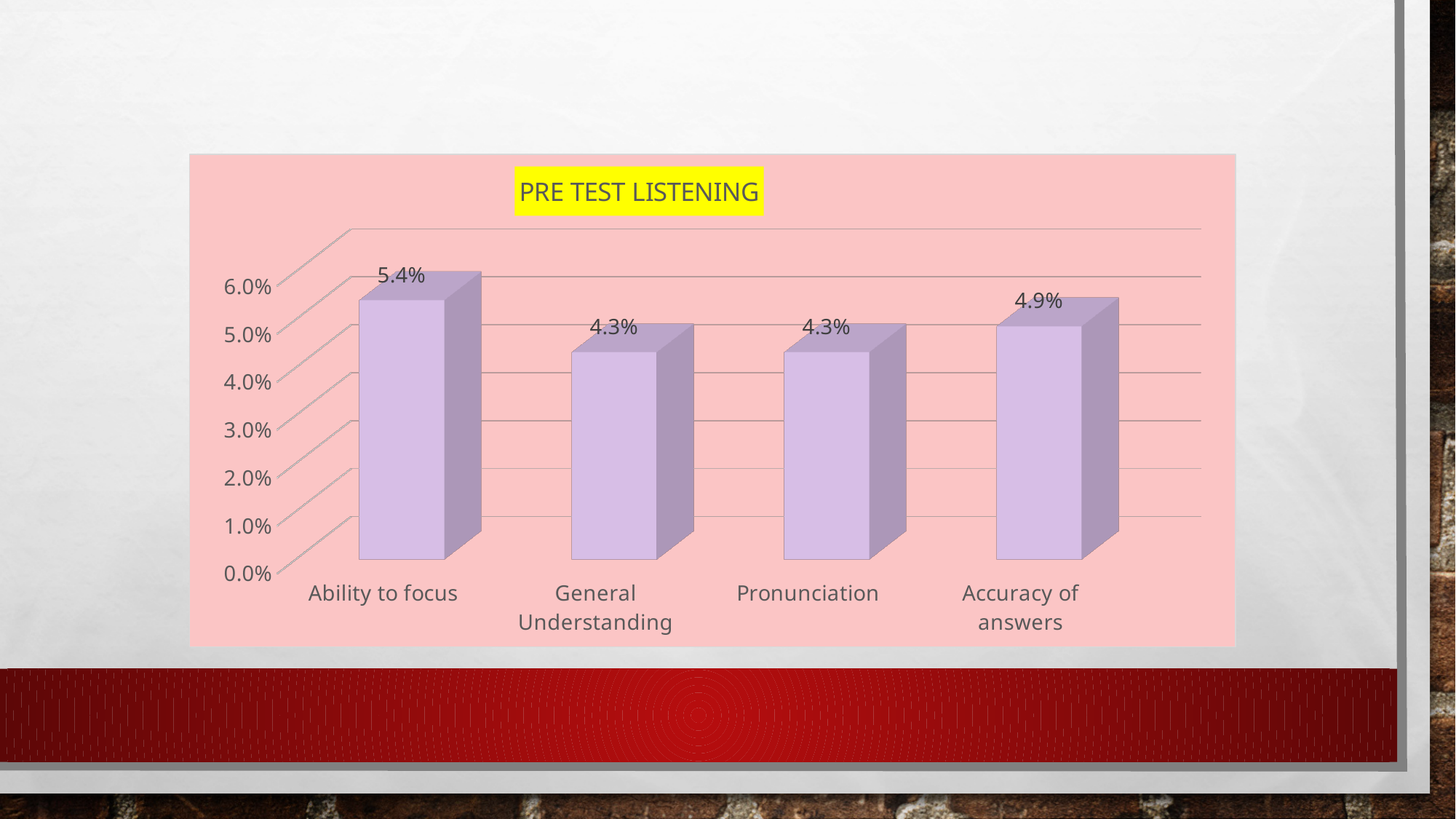
How many categories are shown in the chart? 4 What kind of chart is shown on the slide? Bar chart What is the value for General Understanding? 4.3% What is the title of the chart? PRE TEST LISTENING What is the value for Ability to focus? 5.4% What is the value for Pronunciation? 4.3% What is the difference between the values for Ability to focus and Accuracy of answers? 0.5% Is the value for Accuracy of answers greater or less than 4.0%? greater What is the value for Accuracy of answers? 4.9% Which is larger, the value for Ability to focus or the value for General Understanding? Ability to focus Which category has the highest value? Ability to focus What is the difference between the values for Accuracy of answers and Pronunciation? 0.6%